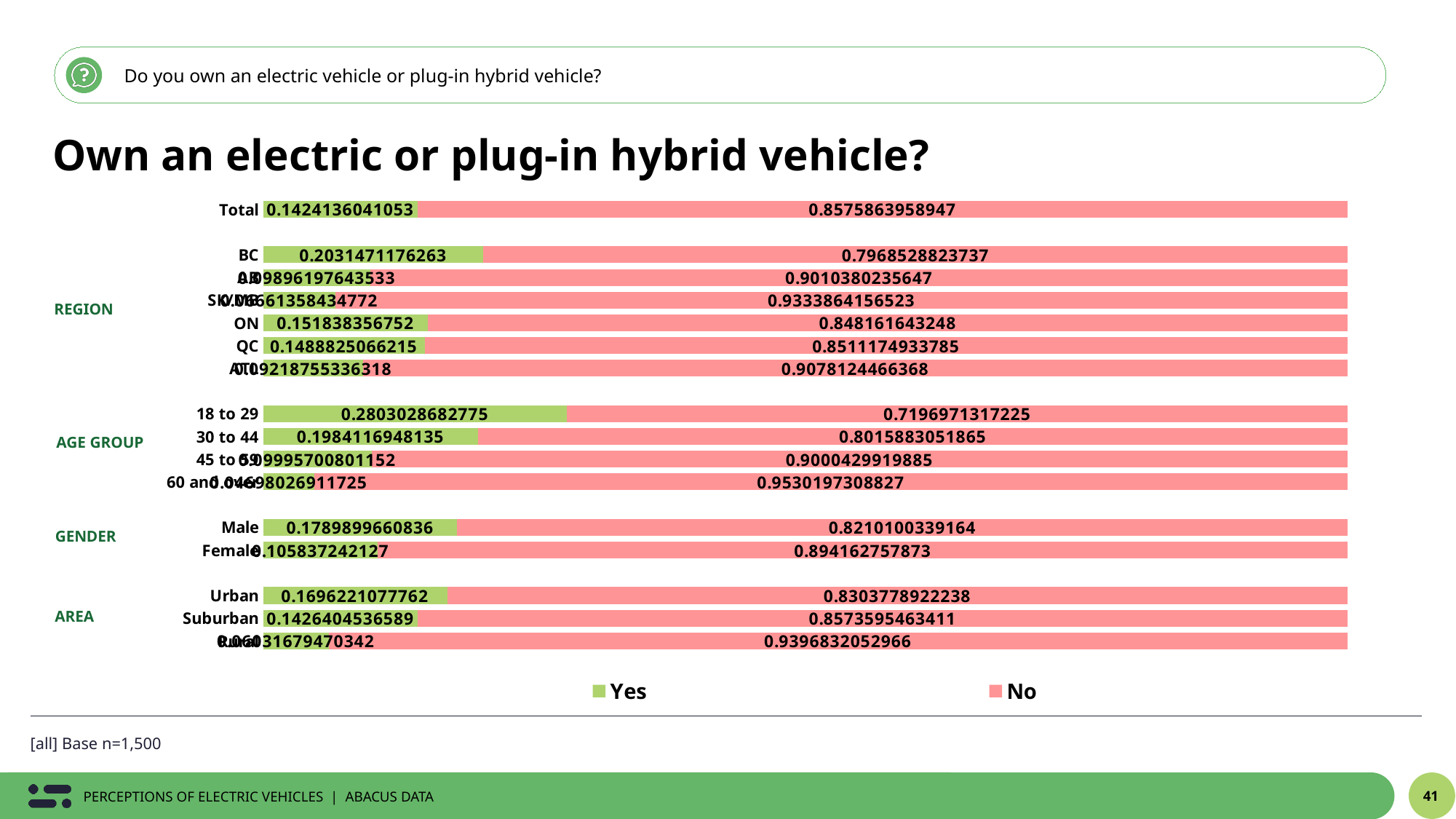
What kind of chart is shown on the slide? Stacked bar chart What is the 'Yes' value for the Total bar? 0.1424136041053 What is the 'No' value for BC? 0.7968528823737 Which category has the highest 'No' value? 60 and over Which has a larger 'Yes' value, BC or ON? BC What is the 'No' value for Rural? 0.9396832052966 What is the 'No' value for 60 and over? 0.9530197308827 Which category has the highest 'Yes' value? 18 to 29 What is the difference between the 'Yes' values for 18 to 29 and 30 to 44? 0.081891173464 What is the 'Yes' value for the 18 to 29 age group? 0.2803028682775 How many series does the legend list? 2 What is the total of the 'Yes' and 'No' values for the Total bar? 1.0